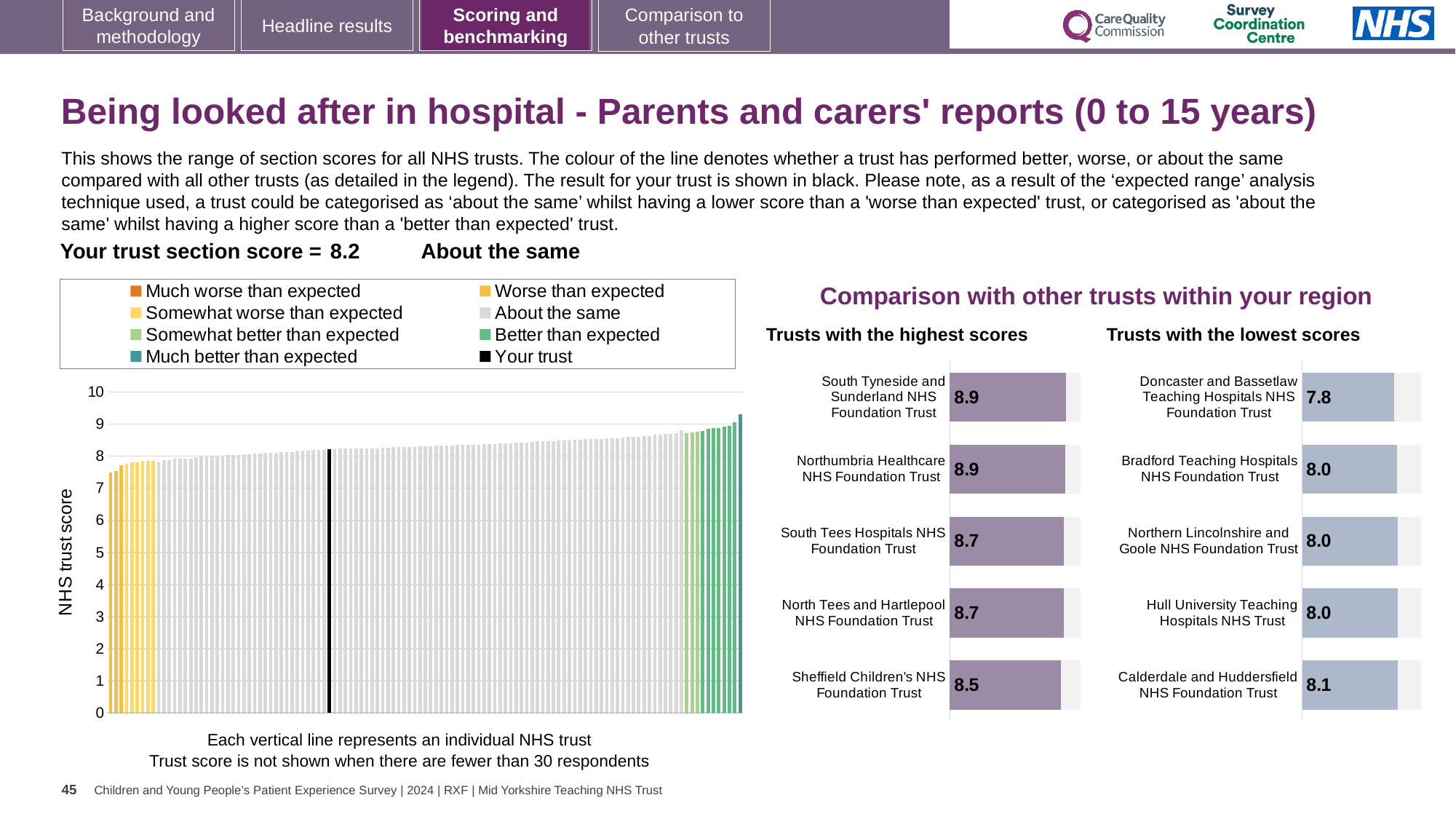
In the 'Trusts with the lowest scores' chart, what is the score for Doncaster and Bassetlaw Teaching Hospitals NHS Foundation Trust? 7.8 In the 'Trusts with the highest scores' chart, what is the score for Sheffield Children's NHS Foundation Trust? 8.5 In the large chart on the left, how many entries does the legend list? 8 In the large chart on the left, do the trust scores rise or fall from left to right along the x axis? Rise In the 'Trusts with the lowest scores' chart, which trust has the lowest score? Doncaster and Bassetlaw Teaching Hospitals NHS Foundation Trust In the 'Trusts with the lowest scores' chart, what is the difference between the score for Calderdale and Huddersfield NHS Foundation Trust and the score for Doncaster and Bassetlaw Teaching Hospitals NHS Foundation Trust? 0.3 In the 'Trusts with the highest scores' chart, what is the difference between the score for South Tyneside and Sunderland NHS Foundation Trust and the score for Sheffield Children's NHS Foundation Trust? 0.4 What kind of chart is the large chart on the left of the slide? Bar chart Which is larger: the score for Sheffield Children's NHS Foundation Trust in the 'Trusts with the highest scores' chart, or the score for Calderdale and Huddersfield NHS Foundation Trust in the 'Trusts with the lowest scores' chart? Sheffield Children's NHS Foundation Trust In the 'Trusts with the lowest scores' chart, which trust has the highest score? Calderdale and Huddersfield NHS Foundation Trust How many trusts are shown in the 'Trusts with the highest scores' chart? 5 In the 'Trusts with the highest scores' chart, what is the score for South Tees Hospitals NHS Foundation Trust? 8.7